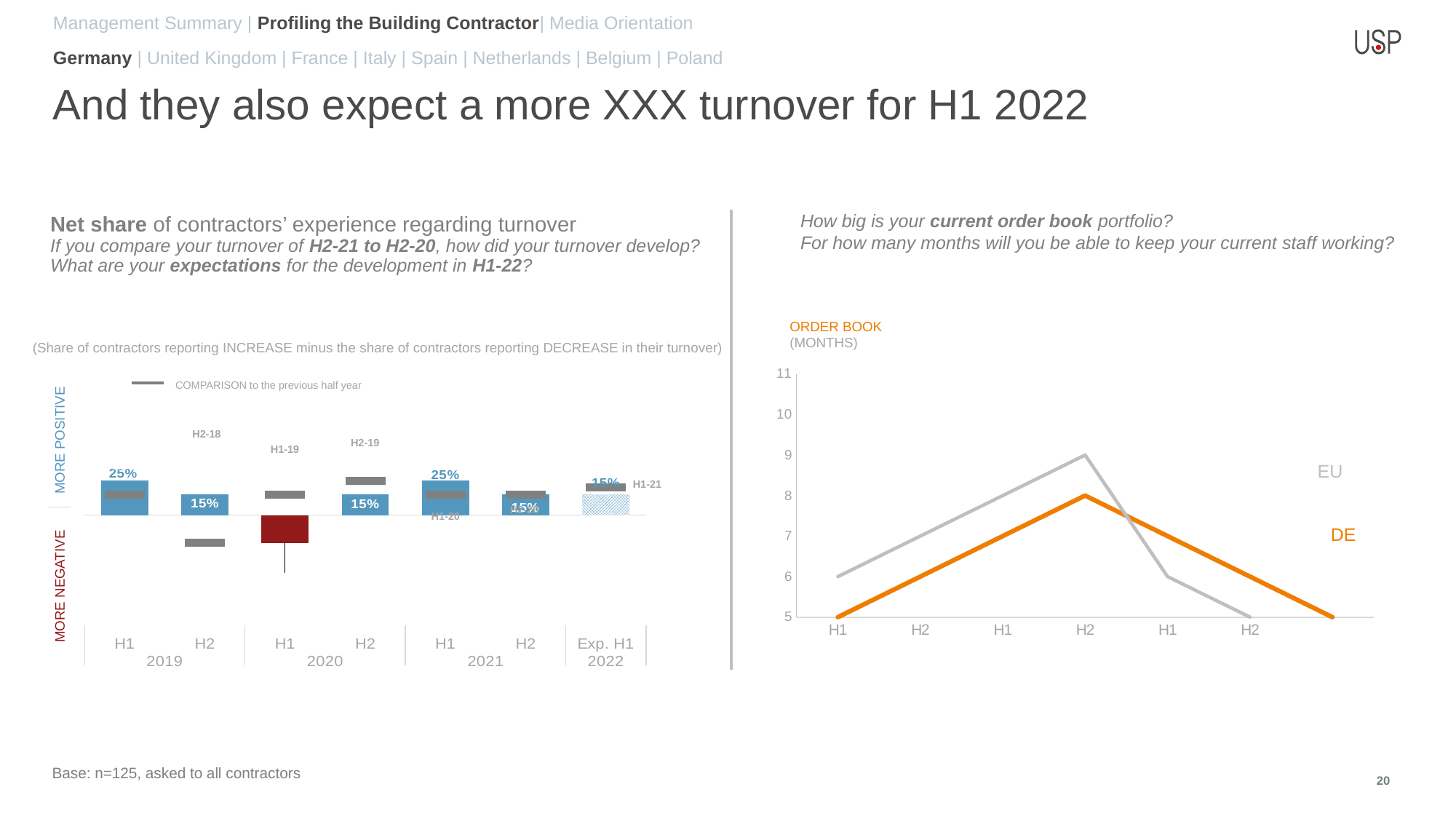
How many series are shown in the right chart on order book (months)? 2 What kind of chart is the left chart on net share of contractors' turnover experience? Bar chart In the left chart on net share of contractors' turnover experience, which half-year shows a negative net share? H1 2020 In the left chart on net share of contractors' turnover experience, what is the value for H1 2021? 25% In the left chart on net share of contractors' turnover experience, what is the value for H1 2019? 25% How many half-year periods are plotted as bars in the left chart on net share of contractors' turnover experience? 7 In the left chart on net share of contractors' turnover experience, what is the value for H2 2019? 15% In the right chart on order book (months), is the peak value of the EU line greater or less than 8? greater What kind of chart is the right chart on order book (months)? Line chart In the left chart on net share of contractors' turnover experience, what is the difference between the values for H1 2021 and H2 2021? 10% In the left chart on net share of contractors' turnover experience, what is the expected value for H1 2022? 15% In the right chart on order book (months), at the first H1 point, which line is higher, EU or DE? EU